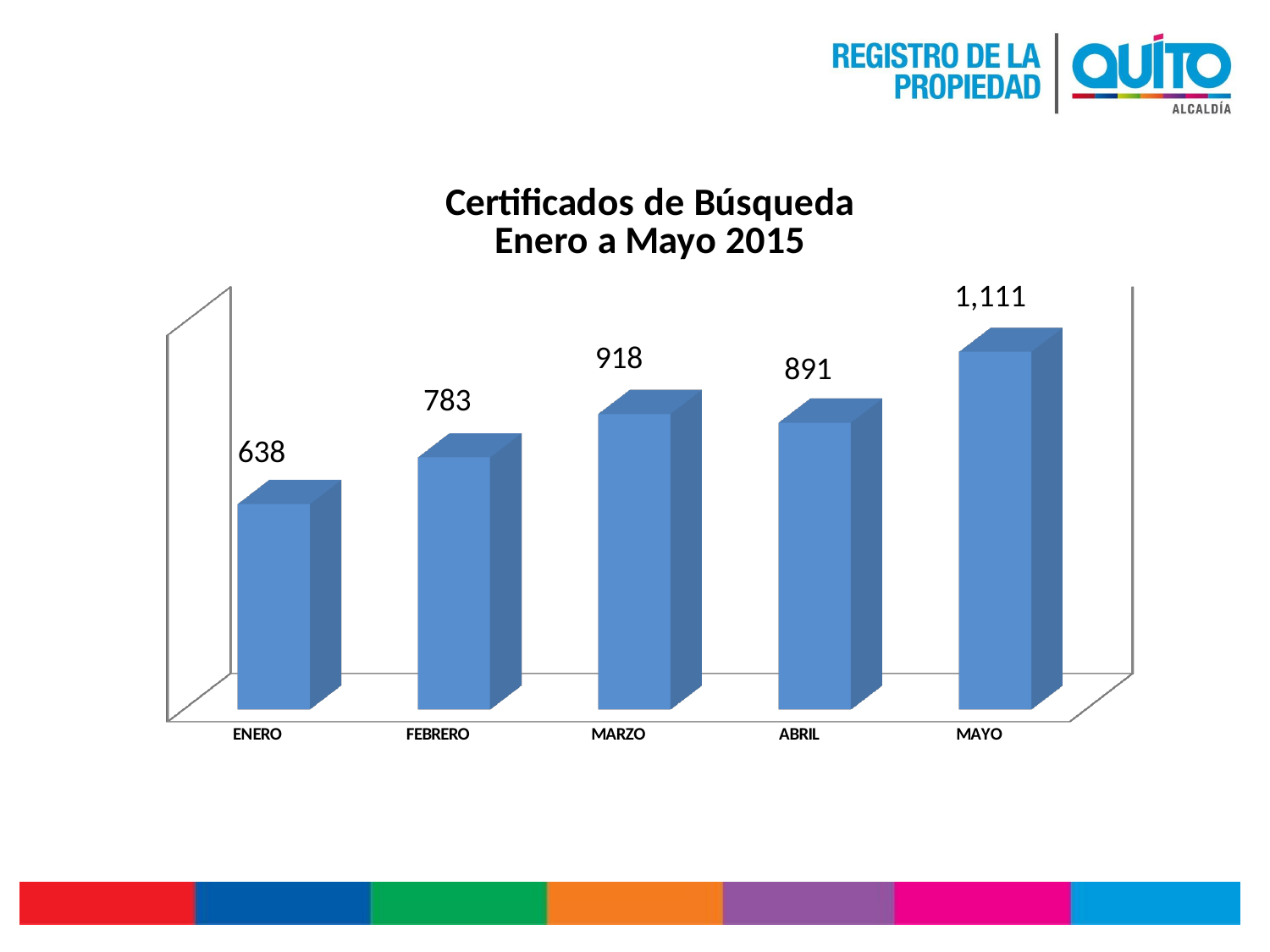
Does the value rise or fall from ENERO to MARZO? rise Which month has the lowest value? ENERO What kind of chart is this? bar chart What is the title of the chart? Certificados de Búsqueda Enero a Mayo 2015 What is the difference between the values for MARZO and ABRIL? 27 Which is larger, the value for FEBRERO or the value for ABRIL? ABRIL What is the difference between the values for MAYO and ENERO? 473 What is the value for ENERO? 638 What is the value for MARZO? 918 Which month has the highest value? MAYO How many months are shown on the chart? 5 What is the value for MAYO? 1,111